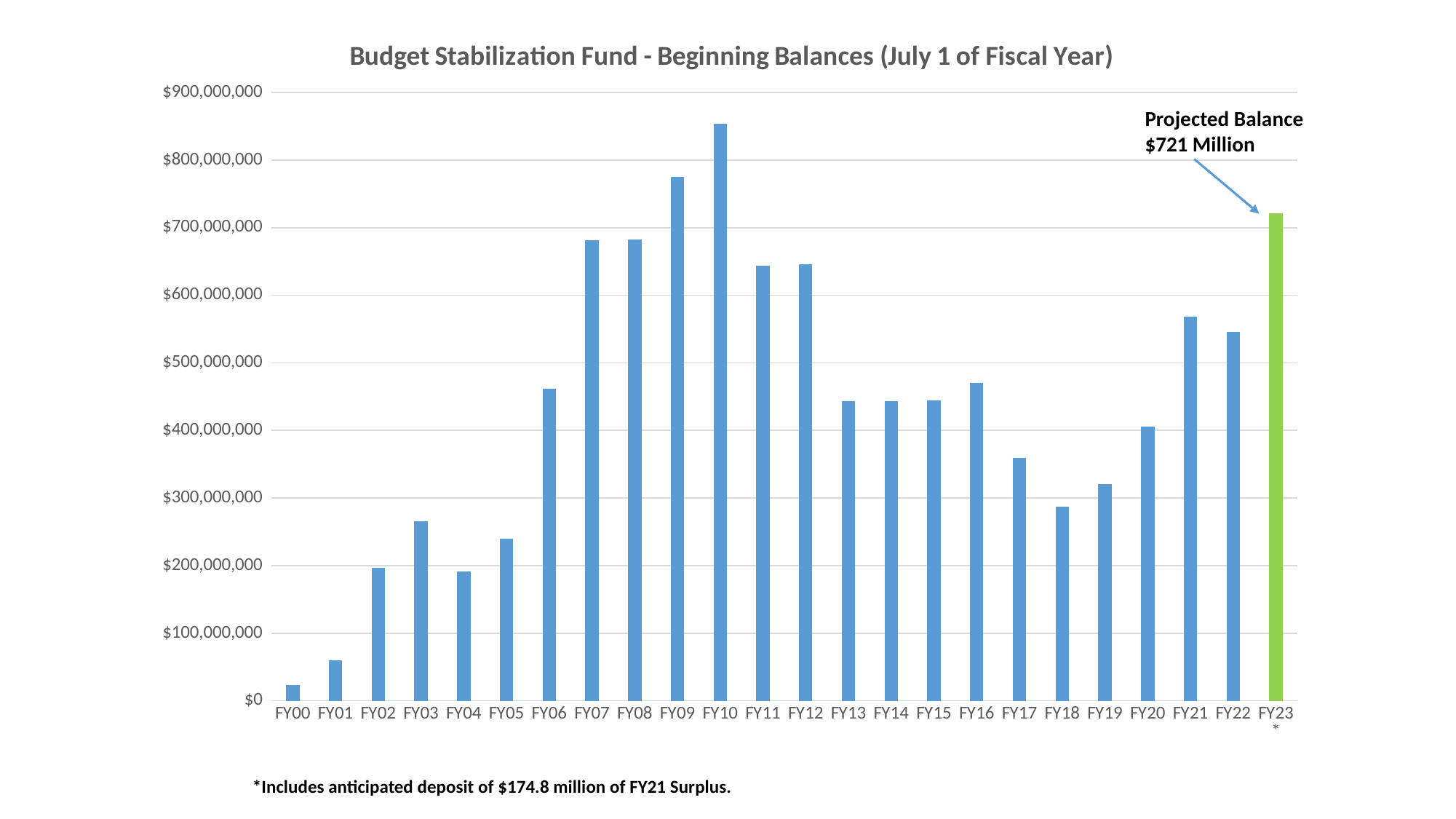
How many fiscal years are shown on the x axis? 24 Do the beginning balances rise or fall from FY10 to FY18? fall Which fiscal year has the highest beginning balance? FY10 What is the projected balance shown for FY23? $721 Million What colour is the FY23 bar? Green Which fiscal year has the lowest beginning balance? FY00 Which has the larger beginning balance, FY21 or FY22? FY21 Is the value for FY06 greater or less than $400,000,000? greater What type of chart is shown on the slide? Bar chart Is the value for FY17 greater or less than $400,000,000? less Which has the larger beginning balance, FY09 or FY10? FY10 Is the value for FY09 greater or less than $700,000,000? greater